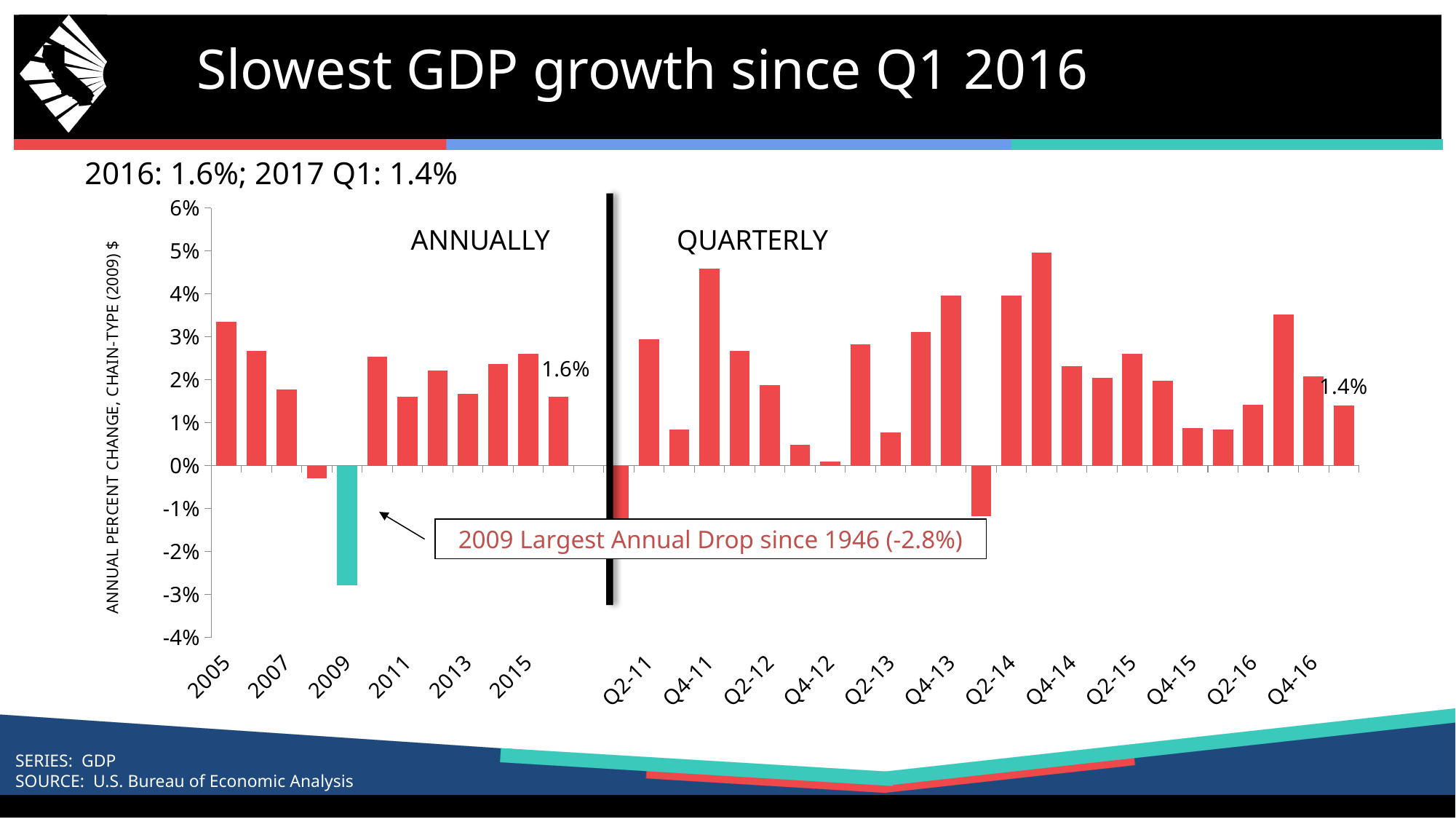
Is the quarterly GDP growth value for Q4-11 greater or less than 4%? greater What kind of chart is shown on the slide? Bar chart What is the difference between the labelled 2016 annual value and the labelled 2017 Q1 value? 0.2% What was the annual GDP change in 2009, as stated in the annotation? -2.8% What colour is the bar for 2009, which differs from the other bars? Teal Is the annual GDP growth value for 2005 greater or less than 3%? greater Do the annual GDP growth values rise or fall from 2005 to 2007? fall What is the label on the vertical axis of the chart? ANNUAL PERCENT CHANGE, CHAIN-TYPE (2009) $ Which year has the higher annual GDP growth, 2005 or 2007? 2005 What is the annual GDP growth value labelled for 2016? 1.6% What is the GDP growth value labelled for the last quarterly bar (2017 Q1)? 1.4% Which year has the lowest annual GDP growth in the chart? 2009